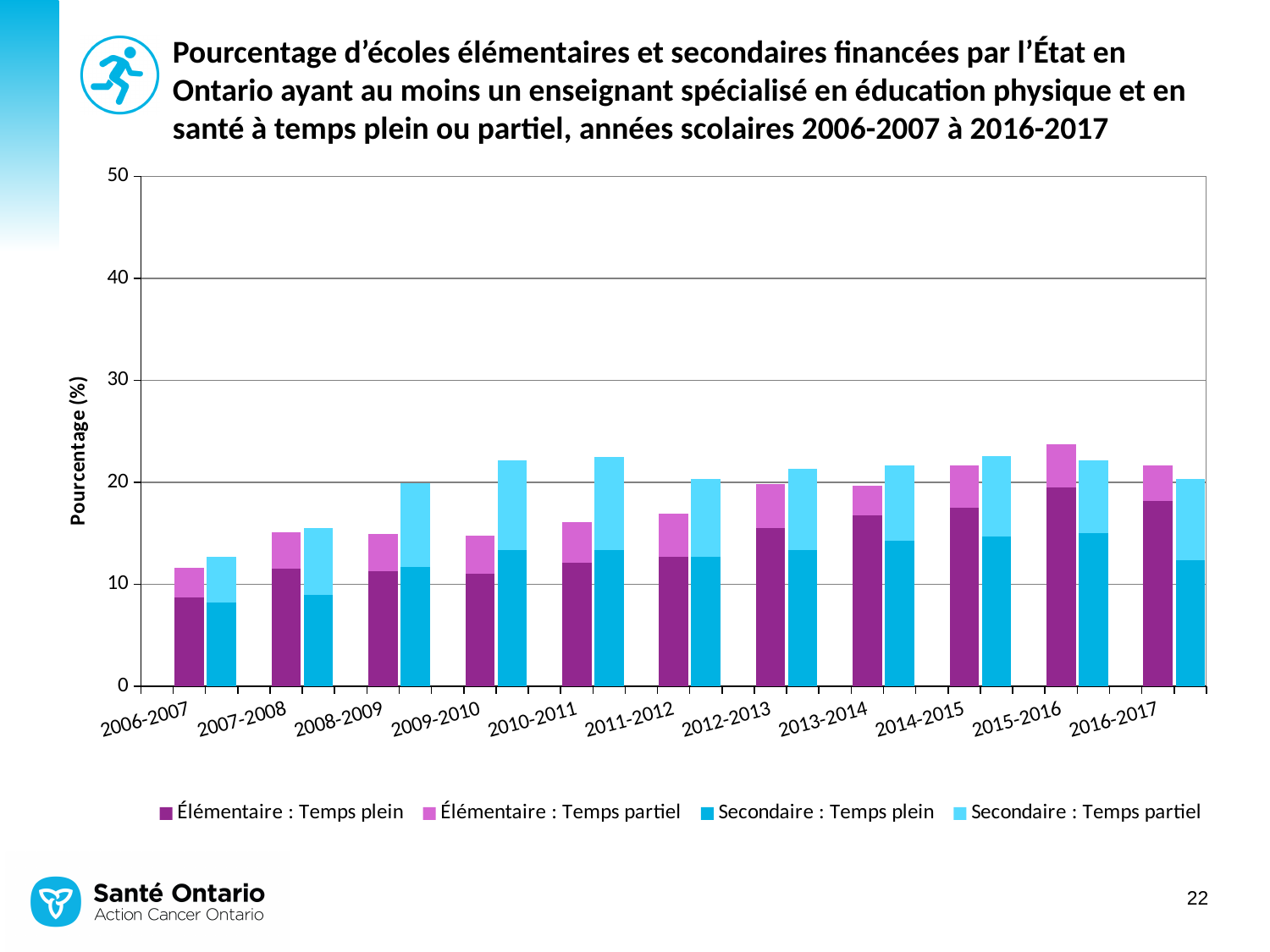
Is the value for Élémentaire : Temps plein in 2006-2007 greater or less than 10? less How many school years are shown on the x axis of the chart? 11 Does the Élémentaire : Temps plein value generally rise or fall from 2006-2007 to 2016-2017? Rise In 2009-2010, which stacked bar is taller: élémentaire or secondaire? Secondaire Which school year has the shortest stacked bar for élémentaire (temps plein plus temps partiel)? 2006-2007 How many series does the chart's legend list? 4 Is the total stacked value for élémentaire in 2015-2016 greater or less than 20? greater Which school year has the tallest stacked bar for élémentaire (temps plein plus temps partiel)? 2015-2016 What kind of chart is shown on the slide? Stacked bar chart Is the total stacked value for élémentaire in 2006-2007 greater or less than 20? less What is the label of the vertical axis? Pourcentage (%) Which school year has the shortest stacked bar for secondaire (temps plein plus temps partiel)? 2006-2007